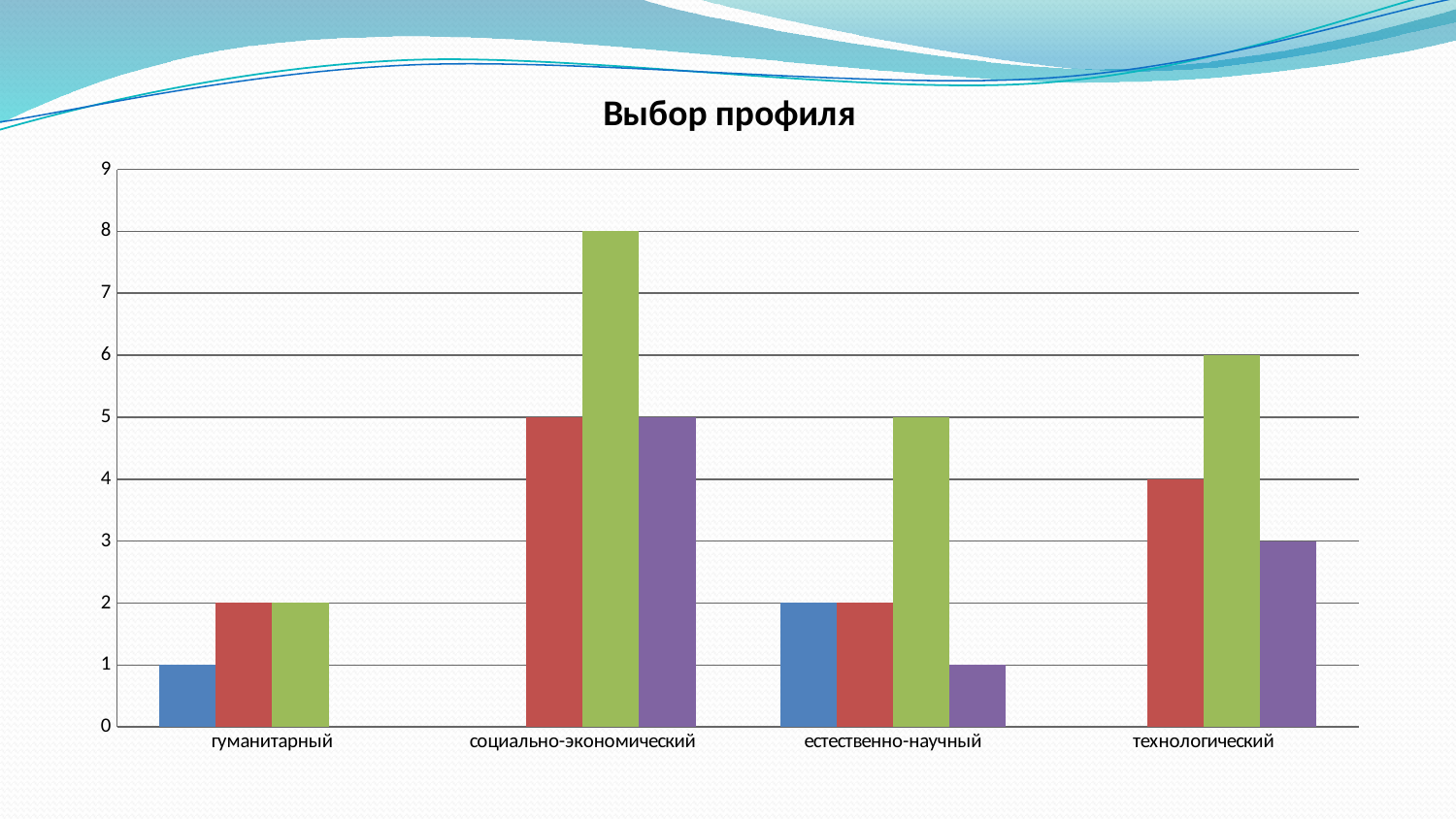
How many categories are shown on the x axis? 4 How many bars are shown for the category гуманитарный? 3 What is the value of the purple bar for технологический? 3 What is the value of the red bar for естественно-научный? 2 Which is larger for естественно-научный: the green bar or the purple bar? the green bar What is the value of the blue bar for гуманитарный? 1 Which category has the lowest red bar? гуманитарный and естественно-научный (both 2) Which category has the highest green bar? социально-экономический What kind of chart is shown on the slide? bar chart What is the title of the chart? Выбор профиля What is the difference between the green bar and the red bar for технологический? 2 What is the value of the green bar for социально-экономический? 8